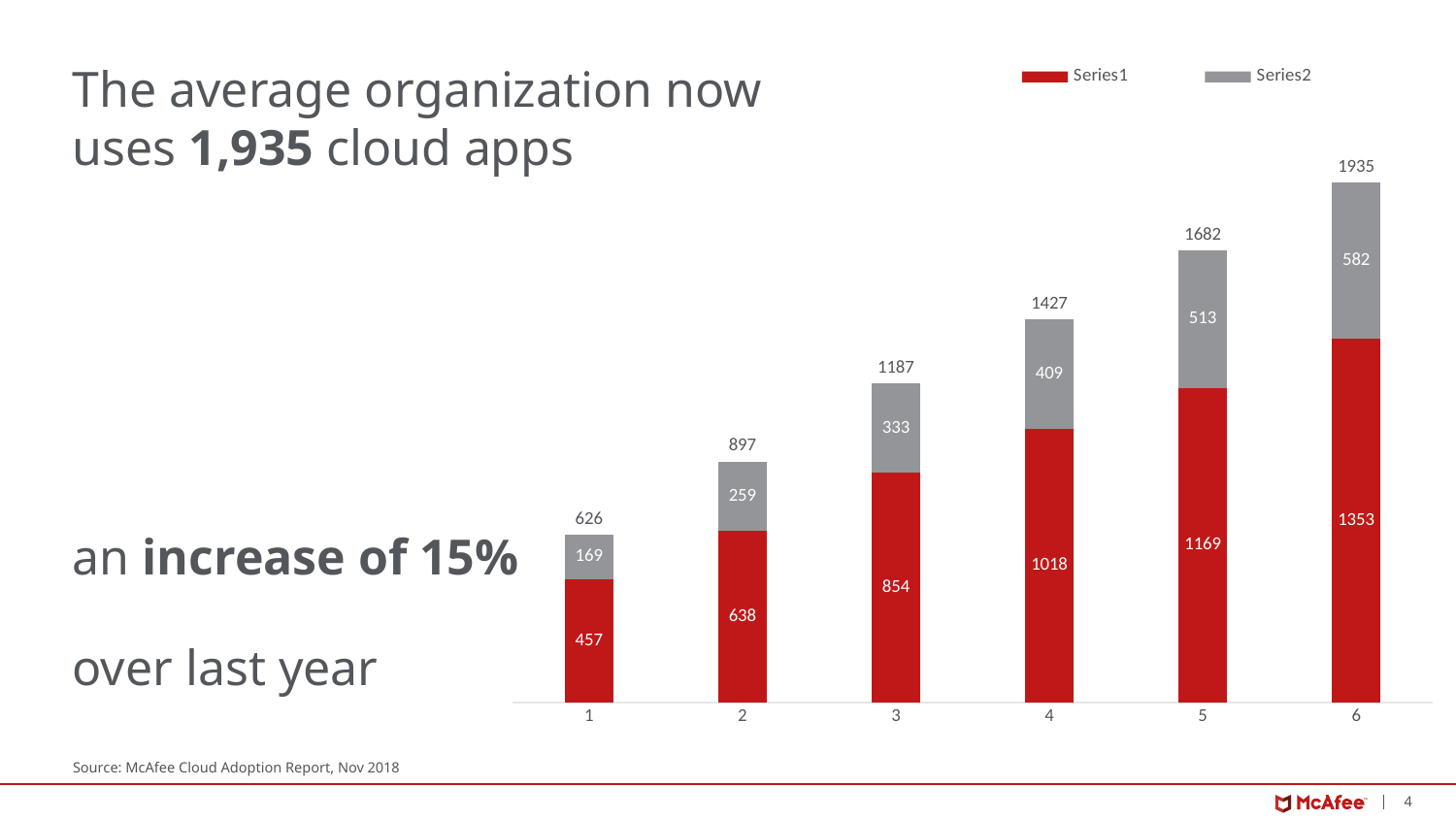
What is the difference between the Series1 values for category 6 and category 5? 184 What is the Series1 value for category 3? 854 How many series does the legend list? 2 Do the bar totals rise or fall from category 1 to category 6? Rise Which category has the lowest Series1 value? 1 What is the total of the stacked bar for category 2? 897 Which category has the highest total? 6 What kind of chart is shown on the slide? Stacked bar chart What is the Series2 value for category 5? 513 Which is larger, the Series2 value for category 4 or the Series2 value for category 3? Series2 value for category 4 What is the total of the stacked bar for category 6? 1935 How many categories are shown on the x axis? 6